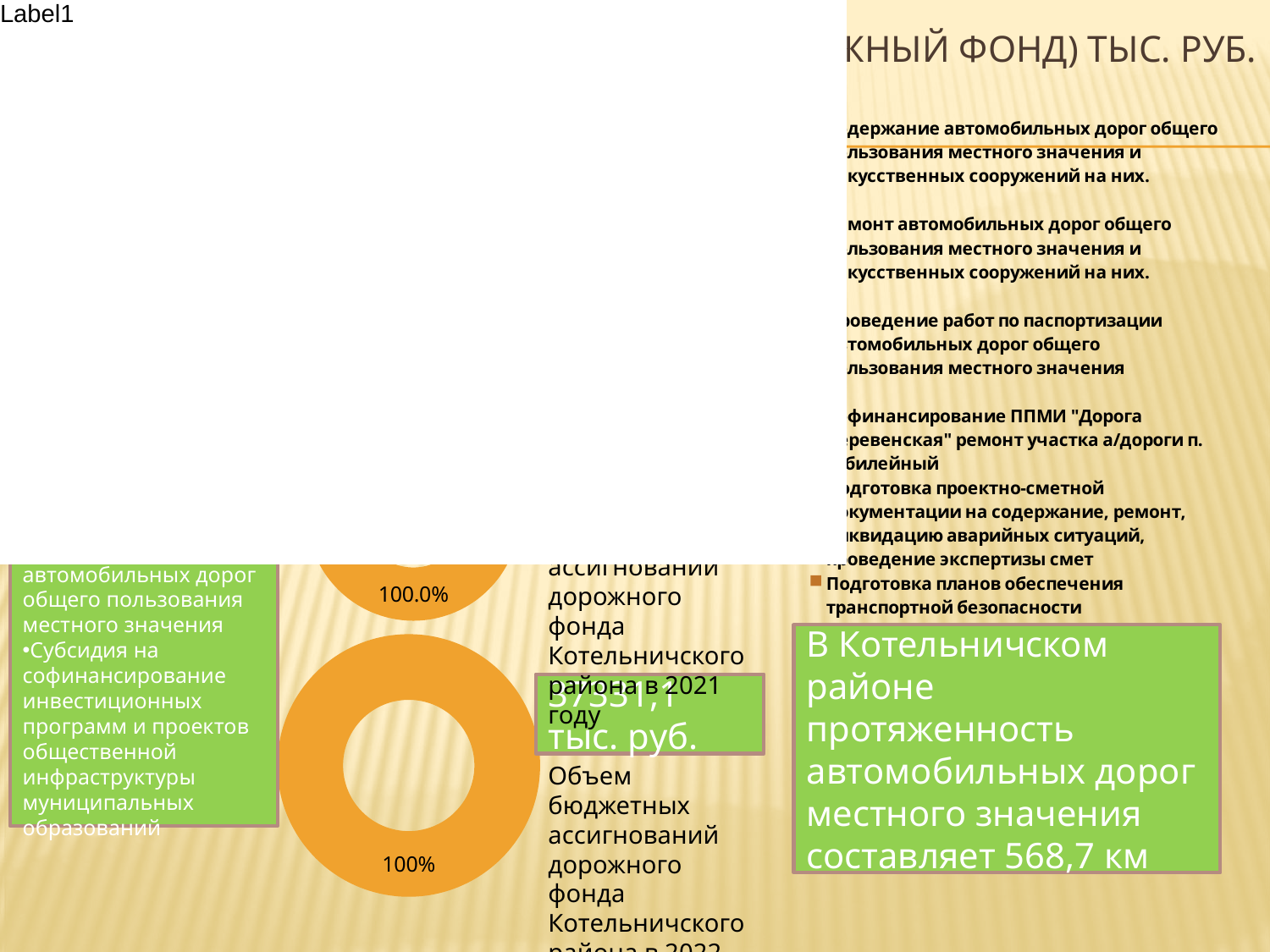
How many doughnut charts are visible on the slide? 2 What data label is printed on the upper doughnut chart? 100.0% What type of chart are the two orange ring-shaped charts on the slide? doughnut chart What data label is printed on the lower doughnut chart? 100% What colour are the rings of the doughnut charts? orange